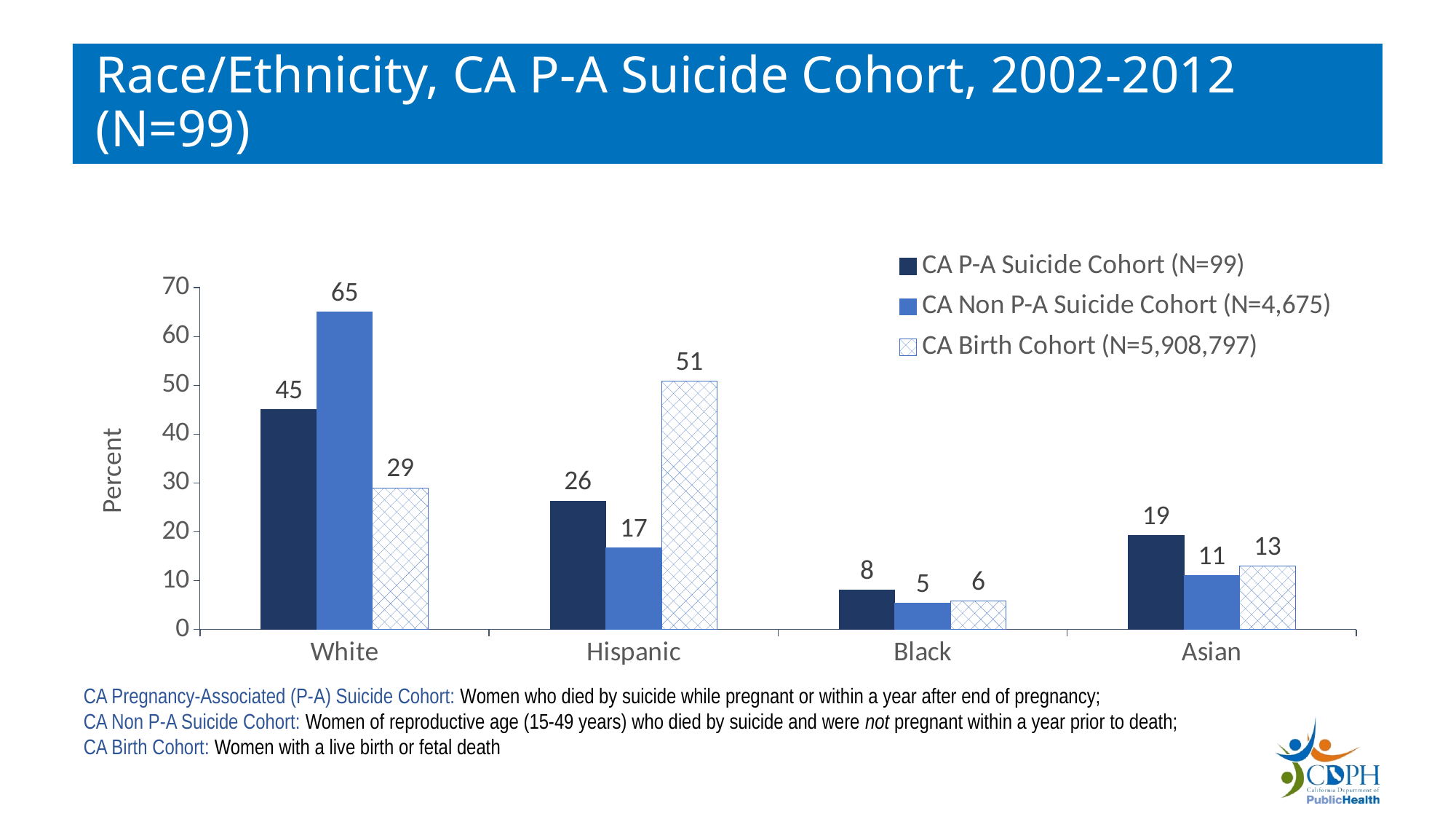
What kind of chart is shown on the slide? bar chart Which race/ethnicity category has the highest value in the CA Non P-A Suicide Cohort (N=4,675) series? White Is the value for Hispanic in the CA P-A Suicide Cohort series greater or less than 30? less What is the value for Hispanic in the CA Birth Cohort (N=5,908,797) series? 51 What is the difference between the CA Non P-A Suicide Cohort and CA P-A Suicide Cohort values for White? 20 How many series does the legend list? 3 For Black, which series has the larger value: CA P-A Suicide Cohort or CA Birth Cohort? CA P-A Suicide Cohort How many race/ethnicity categories are shown on the x axis? 4 What is the value for White in the CA P-A Suicide Cohort (N=99) series? 45 What is the value for Asian in the CA Non P-A Suicide Cohort (N=4,675) series? 11 Which race/ethnicity category has the lowest value in the CA P-A Suicide Cohort (N=99) series? Black What is the difference between the CA Birth Cohort and CA Non P-A Suicide Cohort values for Hispanic? 34